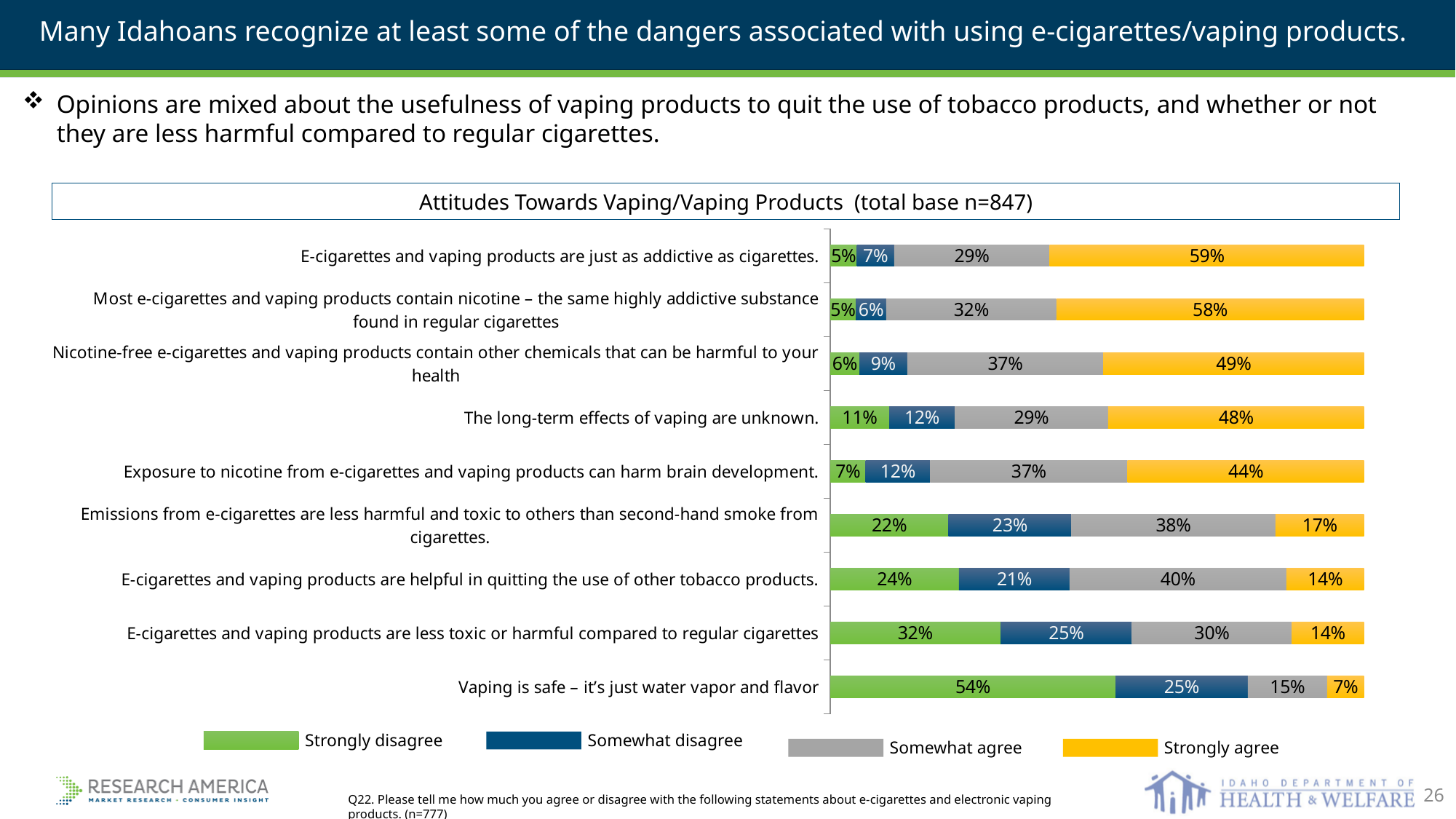
Which statement has the highest 'Strongly agree' percentage? E-cigarettes and vaping products are just as addictive as cigarettes. How many statements are shown in the chart? 9 What percentage somewhat agree that e-cigarettes and vaping products are helpful in quitting the use of other tobacco products? 40% Which is larger: the 'Strongly disagree' share for 'E-cigarettes and vaping products are less toxic or harmful compared to regular cigarettes' or for 'E-cigarettes and vaping products are helpful in quitting the use of other tobacco products'? E-cigarettes and vaping products are less toxic or harmful compared to regular cigarettes What is the difference between the 'Strongly agree' percentages for 'The long-term effects of vaping are unknown' and 'Exposure to nicotine from e-cigarettes and vaping products can harm brain development'? 4% What percentage strongly agree that e-cigarettes and vaping products are just as addictive as cigarettes? 59% What kind of chart is shown on the slide? Stacked bar chart What percentage strongly disagree with the statement 'Vaping is safe – it's just water vapor and flavor'? 54% What is the total of the four segments for 'The long-term effects of vaping are unknown'? 100% Which statement has the lowest 'Strongly agree' percentage? Vaping is safe – it's just water vapor and flavor What is the title of the chart? Attitudes Towards Vaping/Vaping Products (total base n=847) How many series does the legend list? 4